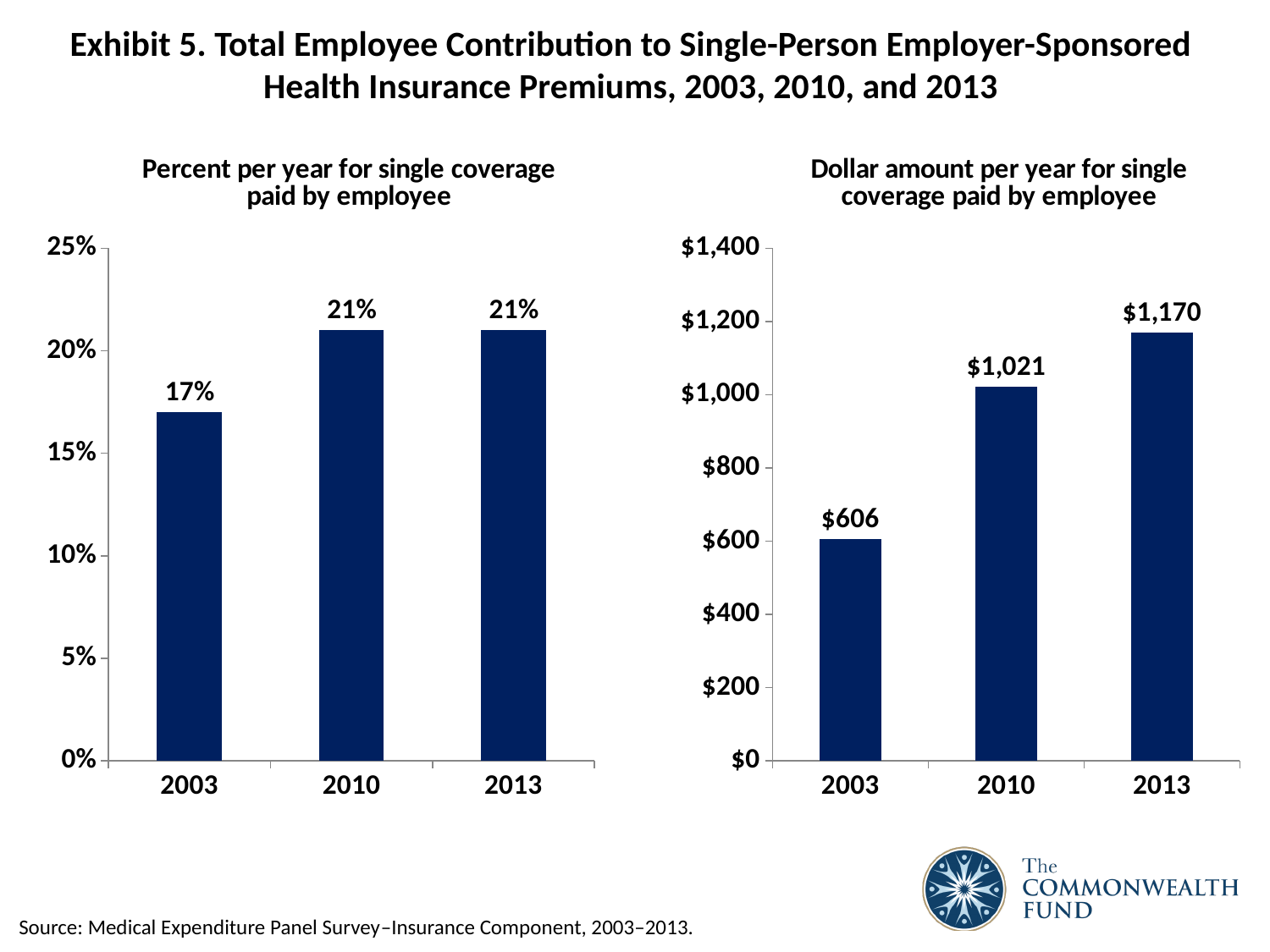
In the 'Percent per year for single coverage paid by employee' chart, what is the difference between the 2010 and 2003 values? 4 percentage points In the 'Dollar amount per year for single coverage paid by employee' chart, which year has the lowest value? 2003 How many years are shown on the x axis of the 'Dollar amount per year for single coverage paid by employee' chart? 3 In the 'Percent per year for single coverage paid by employee' chart, what is the value for 2013? 21% In the 'Dollar amount per year for single coverage paid by employee' chart, is the value for 2003 greater or less than $800? less In the 'Percent per year for single coverage paid by employee' chart, which year has the lowest value? 2003 In the 'Dollar amount per year for single coverage paid by employee' chart, what is the value for 2010? $1,021 What kind of chart is the 'Percent per year for single coverage paid by employee' chart? Bar chart In the 'Dollar amount per year for single coverage paid by employee' chart, which year has the highest value? 2013 In the 'Dollar amount per year for single coverage paid by employee' chart, what is the difference between the 2013 and 2003 values? $564 In the 'Dollar amount per year for single coverage paid by employee' chart, what is the value for 2013? $1,170 In the 'Percent per year for single coverage paid by employee' chart, what is the value for 2003? 17%